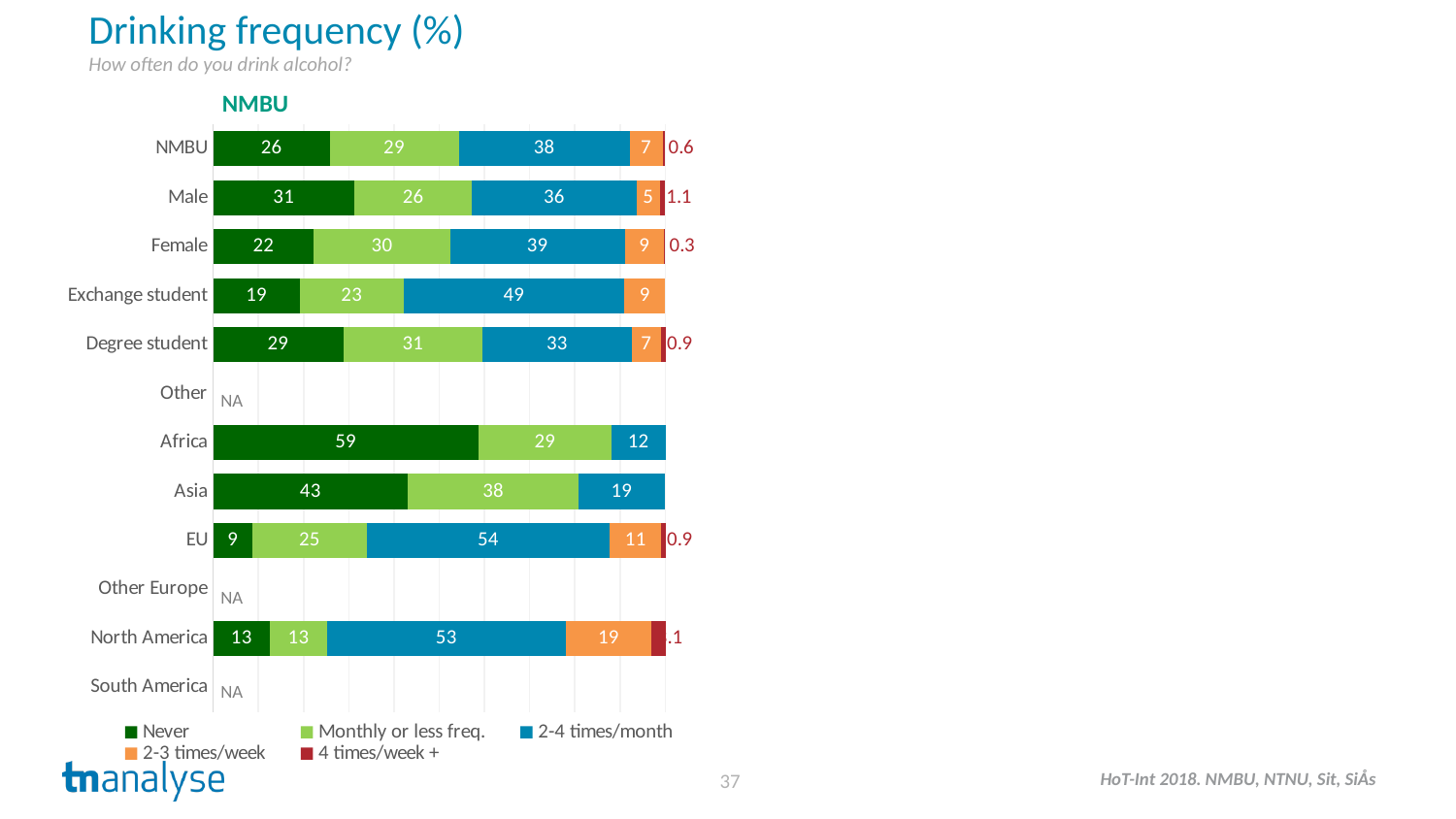
What kind of chart is shown on the slide? stacked bar chart What is the '4 times/week +' value for Male? 1.1 Which category has the lowest 'Never' value among those with data? EU Which is larger, the '2-4 times/month' value for EU or for Asia? EU What is the difference between the 'Never' values for Male and Female? 9 Which categories are marked NA in the chart? Other, Other Europe, South America What is the '2-4 times/month' value for Exchange student? 49 How many categories are listed on the vertical axis of the chart? 12 Which category has the highest 'Never' value? Africa What is the 'Never' value for Africa? 59 What is the '2-3 times/week' value for EU? 11 How many series does the legend list? 5